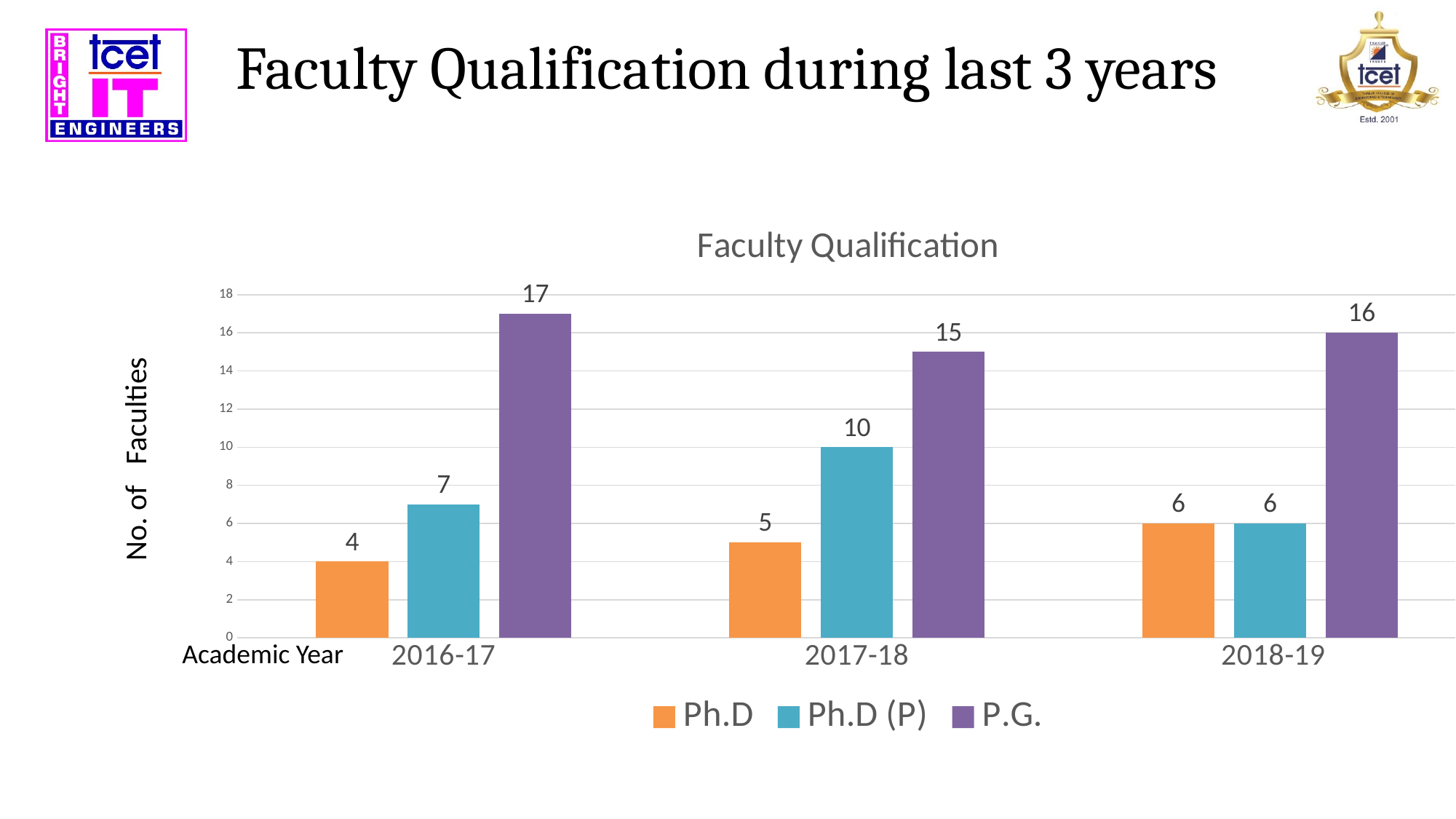
What kind of chart is shown on the slide? Bar chart How many series does the legend list? 3 What is the number of Ph.D faculties in 2016-17? 4 How many academic years are shown on the x axis? 3 In which academic year is the Ph.D value lowest? 2016-17 In which academic year is the P.G. value highest? 2016-17 What is the difference between the P.G. value and the Ph.D value in 2017-18? 10 What is the title of the chart? Faculty Qualification Does the Ph.D value rise or fall from 2016-17 to 2018-19? Rise What is the number of P.G. faculties in 2018-19? 16 What is the number of Ph.D (P) faculties in 2017-18? 10 Which is larger in 2016-17, Ph.D (P) or Ph.D? Ph.D (P)